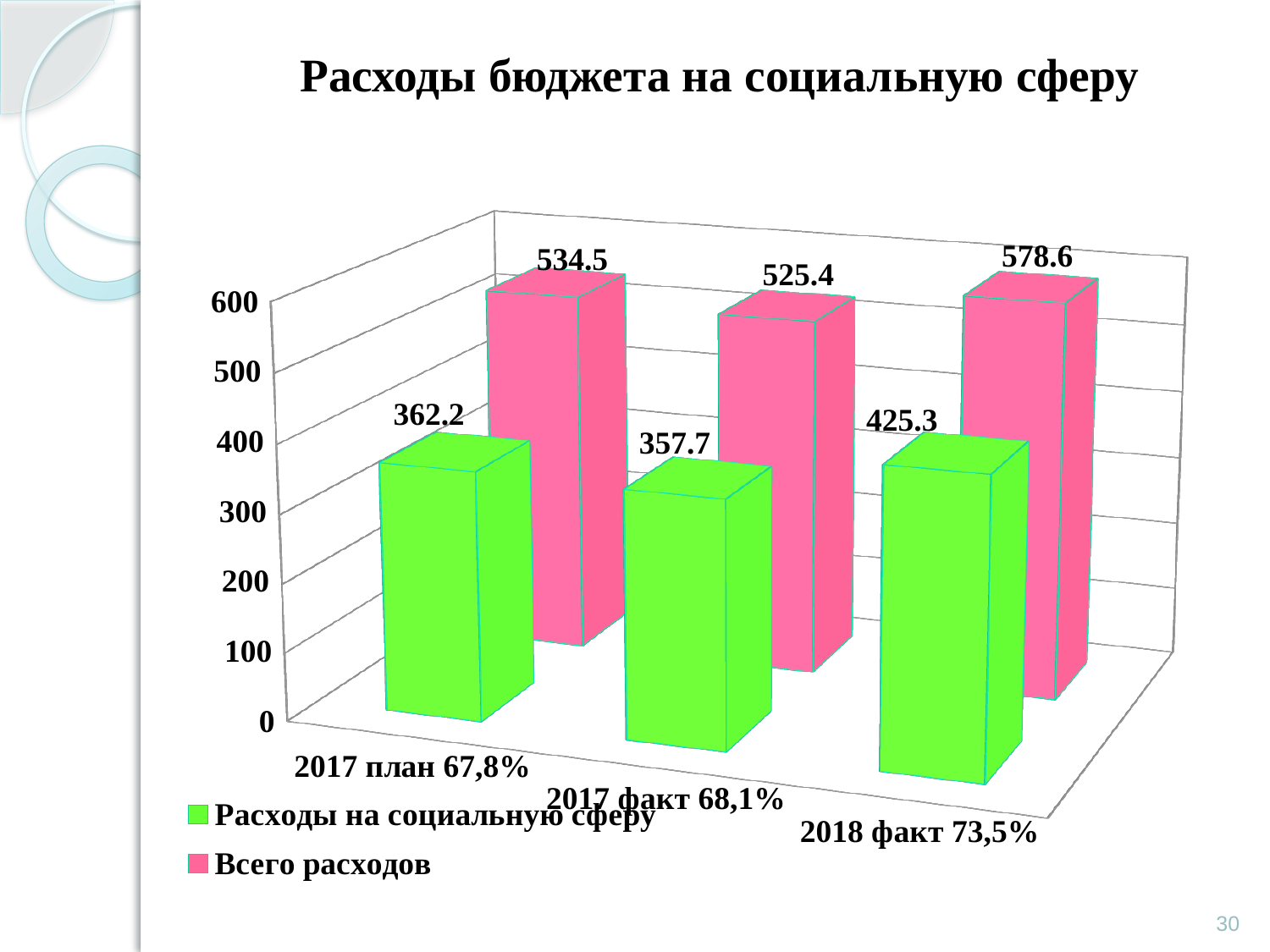
What is the value of "Всего расходов" for "2018 факт 73,5%"? 578.6 How many series does the legend list? 2 Which category has the lowest value for "Всего расходов"? 2017 факт 68,1% What is the value of "Всего расходов" for "2017 факт 68,1%"? 525.4 What is the title of the chart? Расходы бюджета на социальную сферу What is the difference between "Всего расходов" for "2018 факт 73,5%" and for "2017 план 67,8%"? 44.1 How many categories are shown on the x axis? 3 Which category has the highest value for "Расходы на социальную сферу"? 2018 факт 73,5% What is the difference between "Всего расходов" and "Расходы на социальную сферу" for "2018 факт 73,5%"? 153.3 What kind of chart is shown on the slide? Bar chart What is the value of "Расходы на социальную сферу" for "2017 план 67,8%"? 362.2 Which is larger: "Расходы на социальную сферу" for "2017 план 67,8%" or for "2017 факт 68,1%"? 2017 план 67,8%